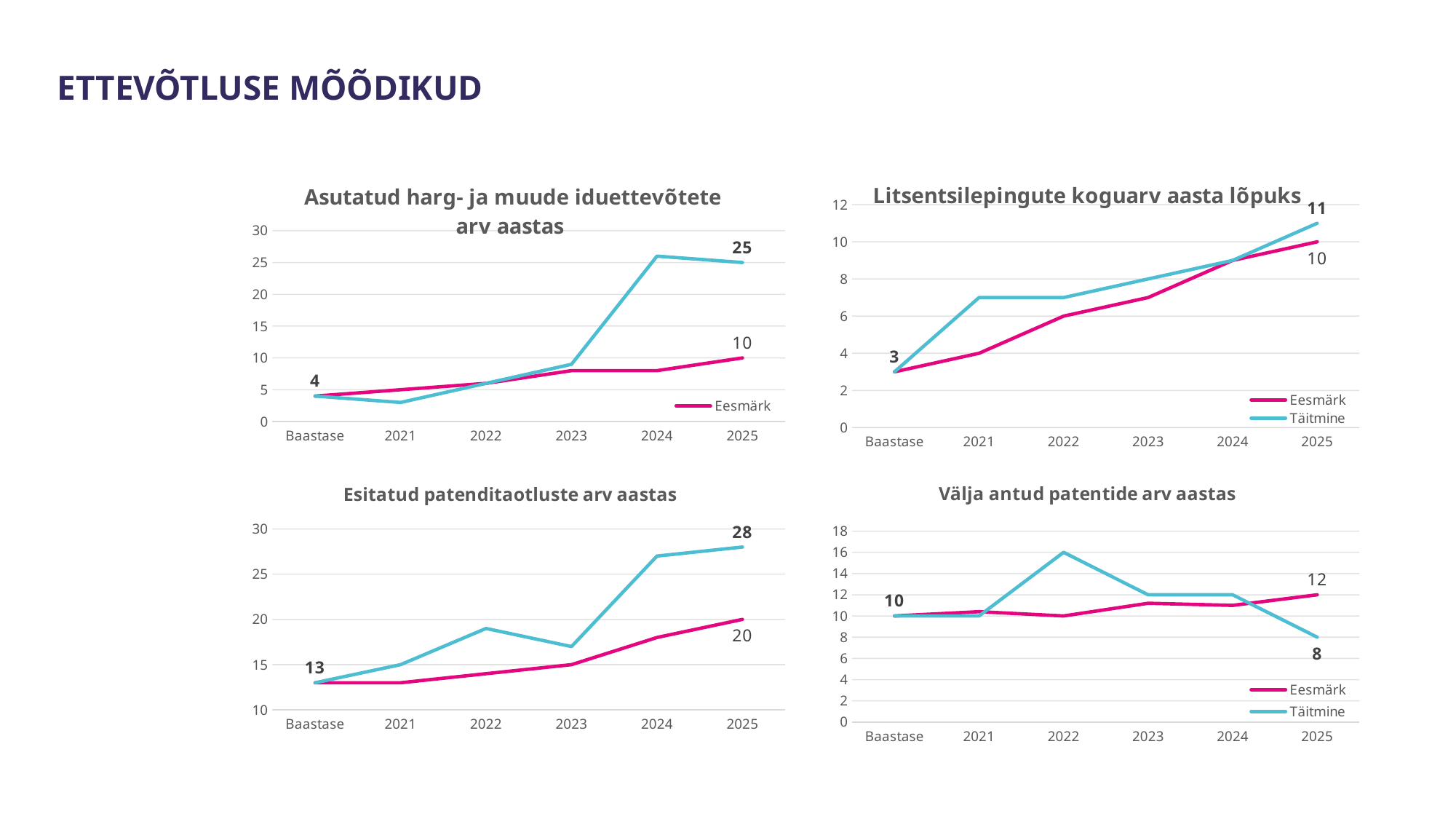
In the chart 'Litsentsilepingute koguarv aasta lõpuks', which is larger in 2025, Eesmärk or Täitmine? Täitmine In the chart 'Asutatud harg- ja muude iduettevõtete arv aastas', what is the Täitmine value for 2025? 25 In the chart 'Litsentsilepingute koguarv aasta lõpuks', what is the Eesmärk value for 2025? 10 In the chart 'Välja antud patentide arv aastas', is the Täitmine value for 2022 greater or less than 14? greater In the chart 'Välja antud patentide arv aastas', what is the Täitmine value for 2025? 8 In the chart 'Välja antud patentide arv aastas', in which year does the Täitmine line reach its highest point? 2022 In the chart 'Esitatud patenditaotluste arv aastas', what is the Täitmine value for 2025? 28 How many points are plotted along the x axis in the chart 'Esitatud patenditaotluste arv aastas'? 6 In the chart 'Asutatud harg- ja muude iduettevõtete arv aastas', what is the Baastase value? 4 In the chart 'Esitatud patenditaotluste arv aastas', what is the difference between the 2025 Täitmine value and the Baastase value? 15 What kind of chart is 'Litsentsilepingute koguarv aasta lõpuks'? Line chart In the chart 'Asutatud harg- ja muude iduettevõtete arv aastas', what is the difference between the Täitmine and Eesmärk values in 2025? 15